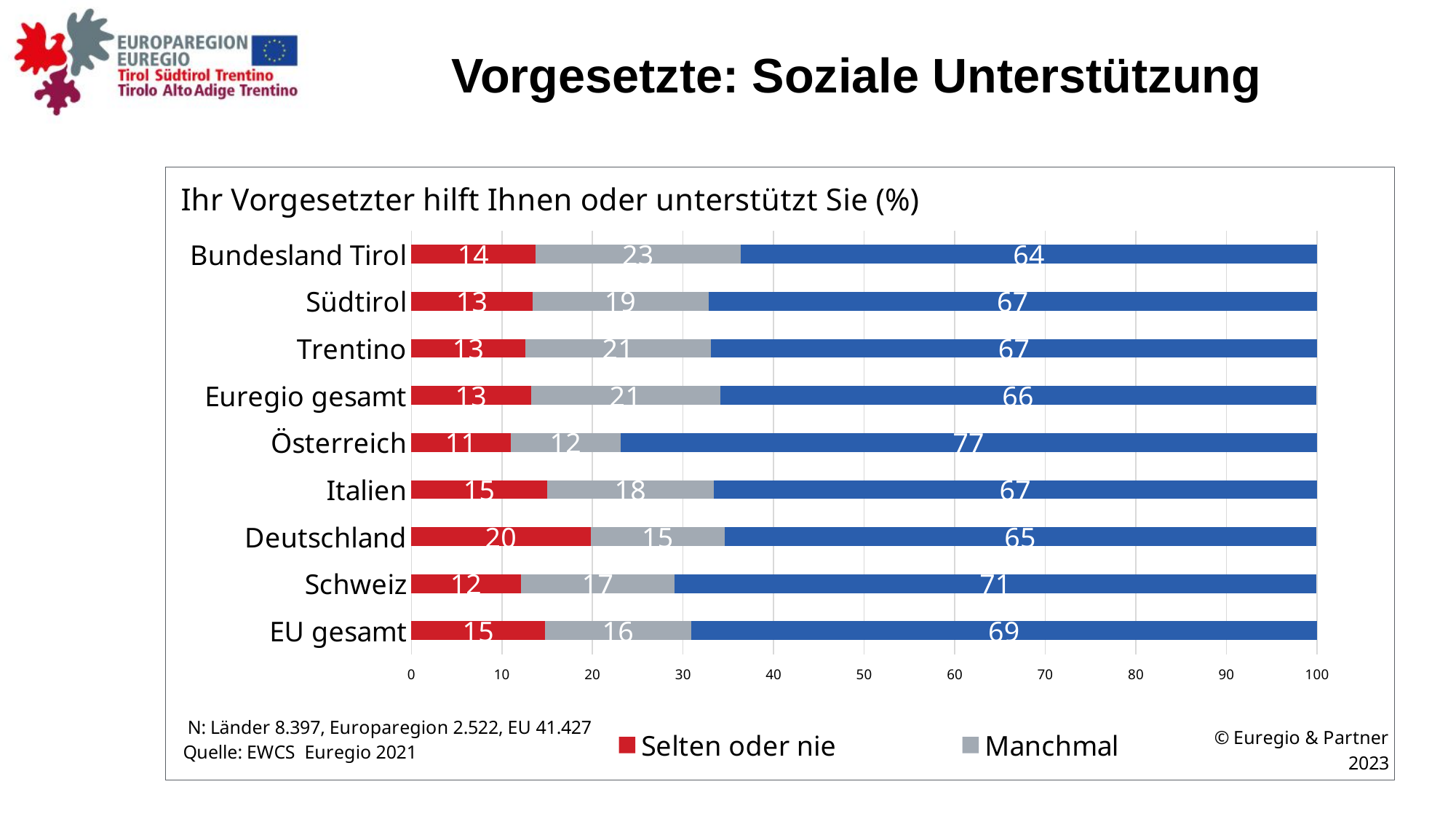
What type of chart is shown on the slide? Stacked bar chart How many series does the legend list? 2 What is the 'Manchmal' value for Bundesland Tirol? 23 What is the 'Manchmal' value for EU gesamt? 16 Which category has the lowest 'Manchmal' value? Österreich What is the title of the chart? Ihr Vorgesetzter hilft Ihnen oder unterstützt Sie (%) What is the blue (largest) segment value for Österreich? 77 What is the difference between the 'Selten oder nie' values for Deutschland and Österreich? 9 How many categories (regions/countries) are shown in the chart? 9 Which is larger: the 'Manchmal' value for Südtirol or for Trentino? Trentino Which category has the highest 'Selten oder nie' value? Deutschland What is the 'Selten oder nie' value for Deutschland? 20